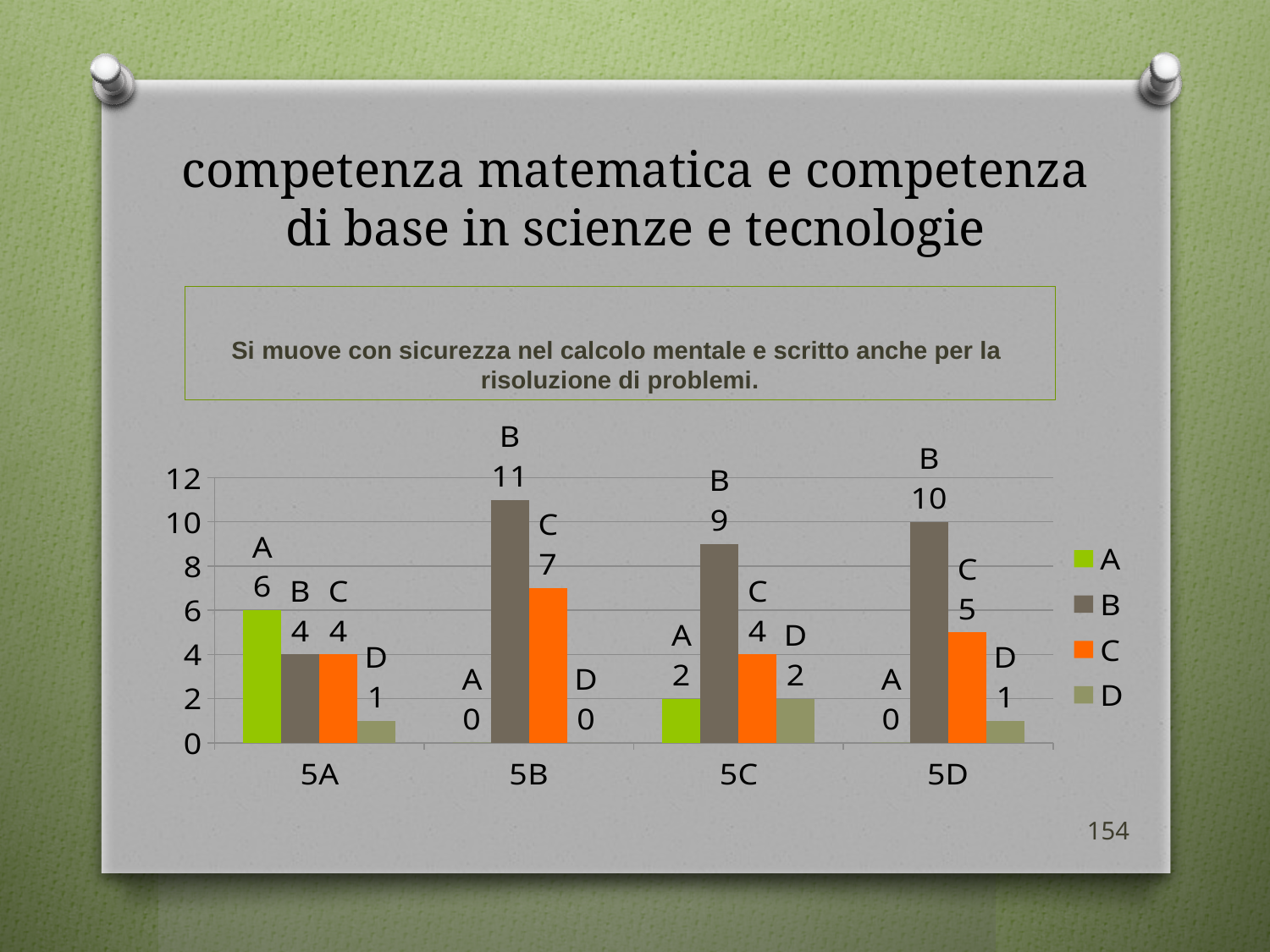
Which class has the highest value for series B? 5B How many series does the legend list? 4 Which class has the lowest value for series C? 5A and 5C What is the value of series D for class 5C? 2 What kind of chart is shown on the slide? bar chart Which is larger for class 5C: series B or series C? B What is the value of series C for class 5D? 5 What is the difference between series B and series C for class 5D? 5 What is the total of all four series for class 5A? 15 What is the value of series B for class 5B? 11 What is the value of series A for class 5A? 6 How many classes are shown on the x axis? 4